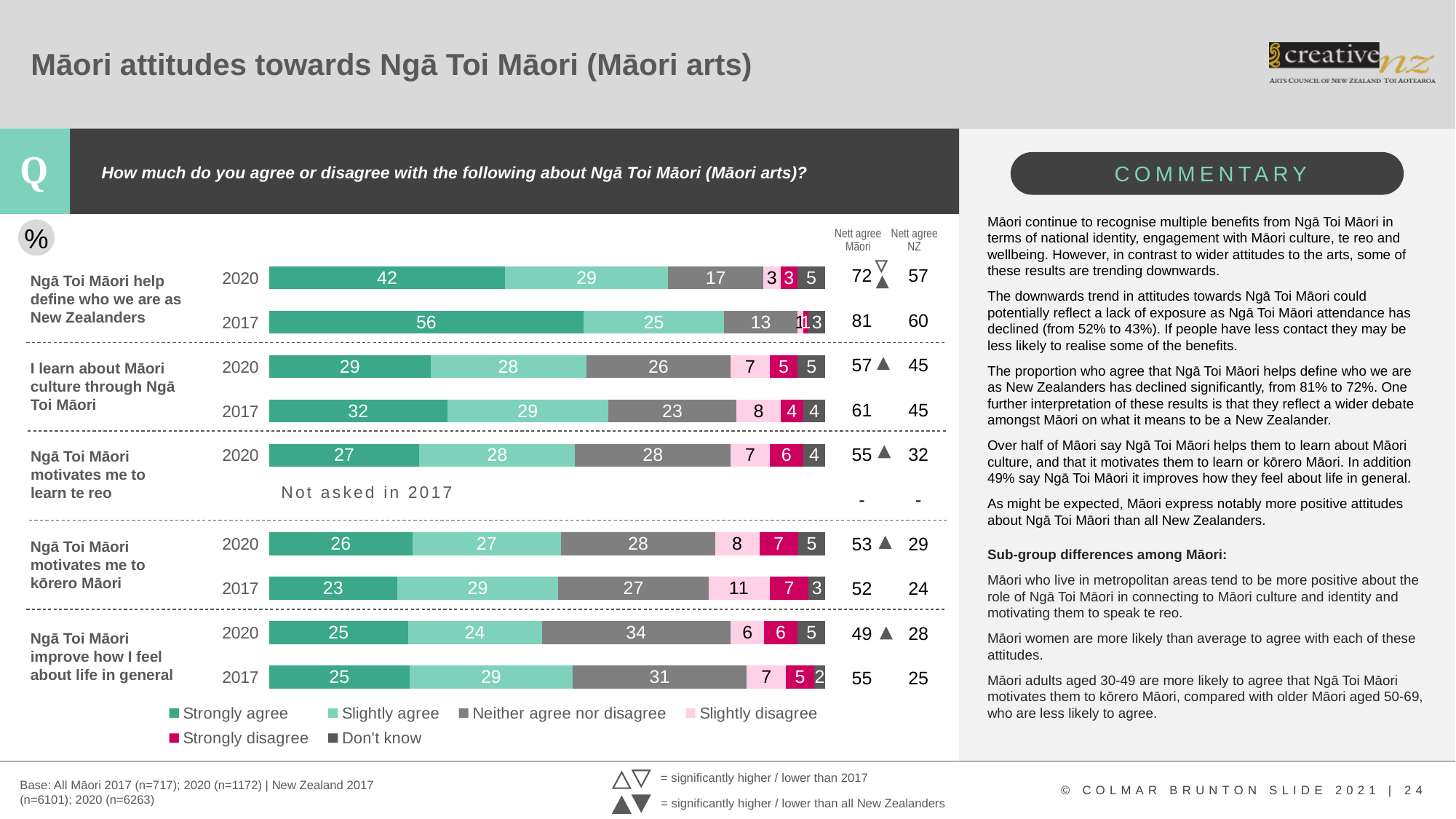
What is the Nett agree Māori figure for 'Ngā Toi Māori motivates me to learn te reo' in 2020? 55 How many series does the legend list? 6 What kind of chart is shown on the slide? Stacked bar chart By how many points did the Nett agree Māori figure for 'Ngā Toi Māori help define who we are as New Zealanders' fall from 2017 to 2020? 9 Which is larger: the 2020 Nett agree Māori figure or the 2020 Nett agree NZ figure for 'I learn about Māori culture through Ngā Toi Māori'? Nett agree Māori Which statement was not asked in 2017? Ngā Toi Māori motivates me to learn te reo What is the combined 'Strongly agree' and 'Slightly agree' value for 'Ngā Toi Māori motivates me to kōrero Māori' in 2020? 53 Which statement and year has the highest 'Strongly agree' value? Ngā Toi Māori help define who we are as New Zealanders, 2017 What was the 'Strongly agree' value in 2017 for 'Ngā Toi Māori help define who we are as New Zealanders'? 56 What is the 'Neither agree nor disagree' value for 'Ngā Toi Māori improve how I feel about life in general' in 2020? 34 How many statements are listed in the chart? 5 What percentage of Māori strongly agreed in 2020 that Ngā Toi Māori help define who we are as New Zealanders? 42